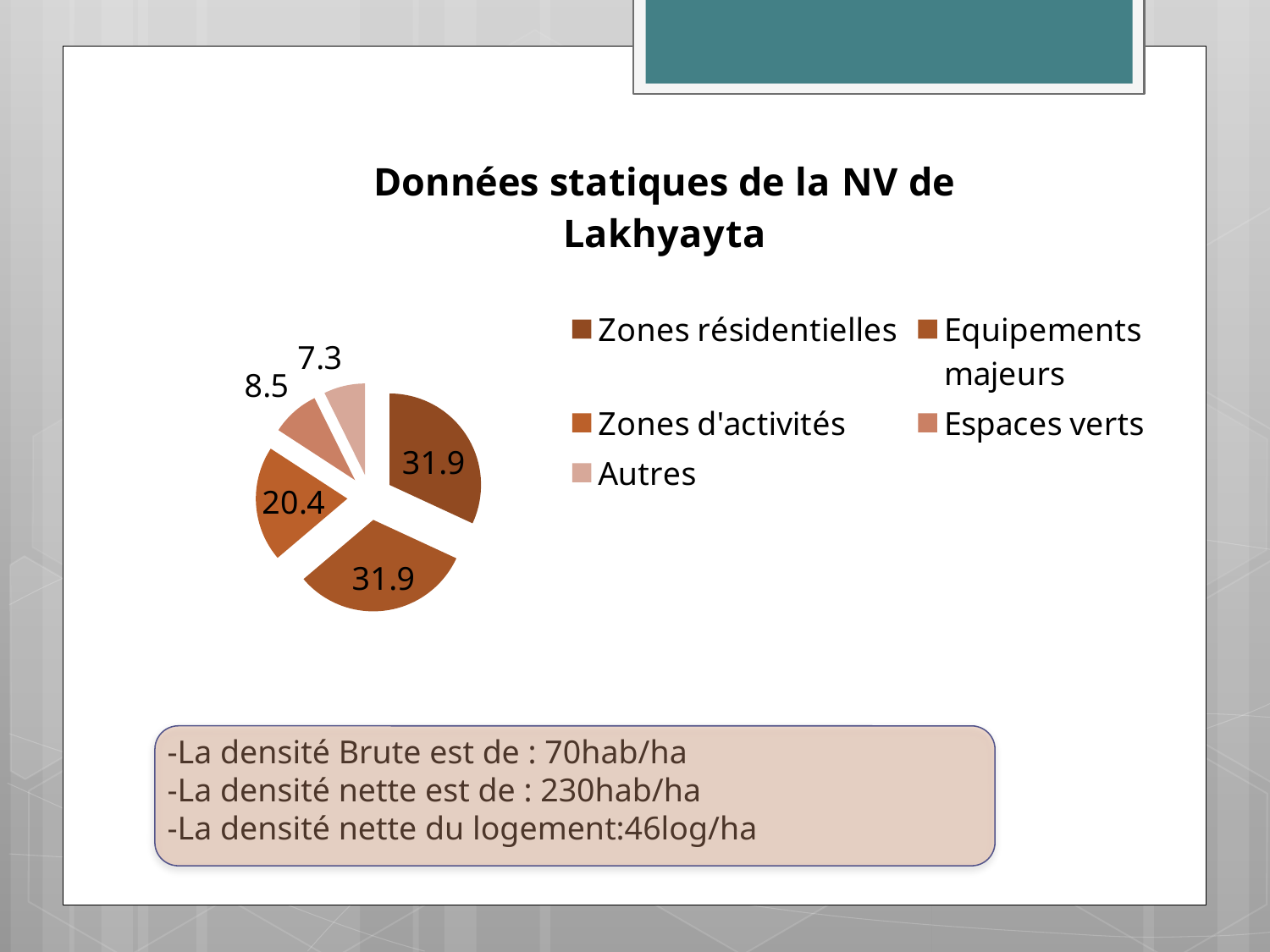
What is the difference between the values for Zones d'activités and Espaces verts? 11.9 What is the value for Zones d'activités? 20.4 What is the value for Autres? 7.3 How many categories does the legend of the pie chart list? 5 What type of chart is shown on the slide? Pie chart What is the value for Zones résidentielles? 31.9 What is the value for Espaces verts? 8.5 Which category has the smallest slice of the pie? Autres What is the title of the chart? Données statiques de la NV de Lakhyayta What is the difference between the values for Zones résidentielles and Autres? 24.6 What is the total of all the values shown on the pie chart? 100 Which is larger, Zones d'activités or Espaces verts? Zones d'activités